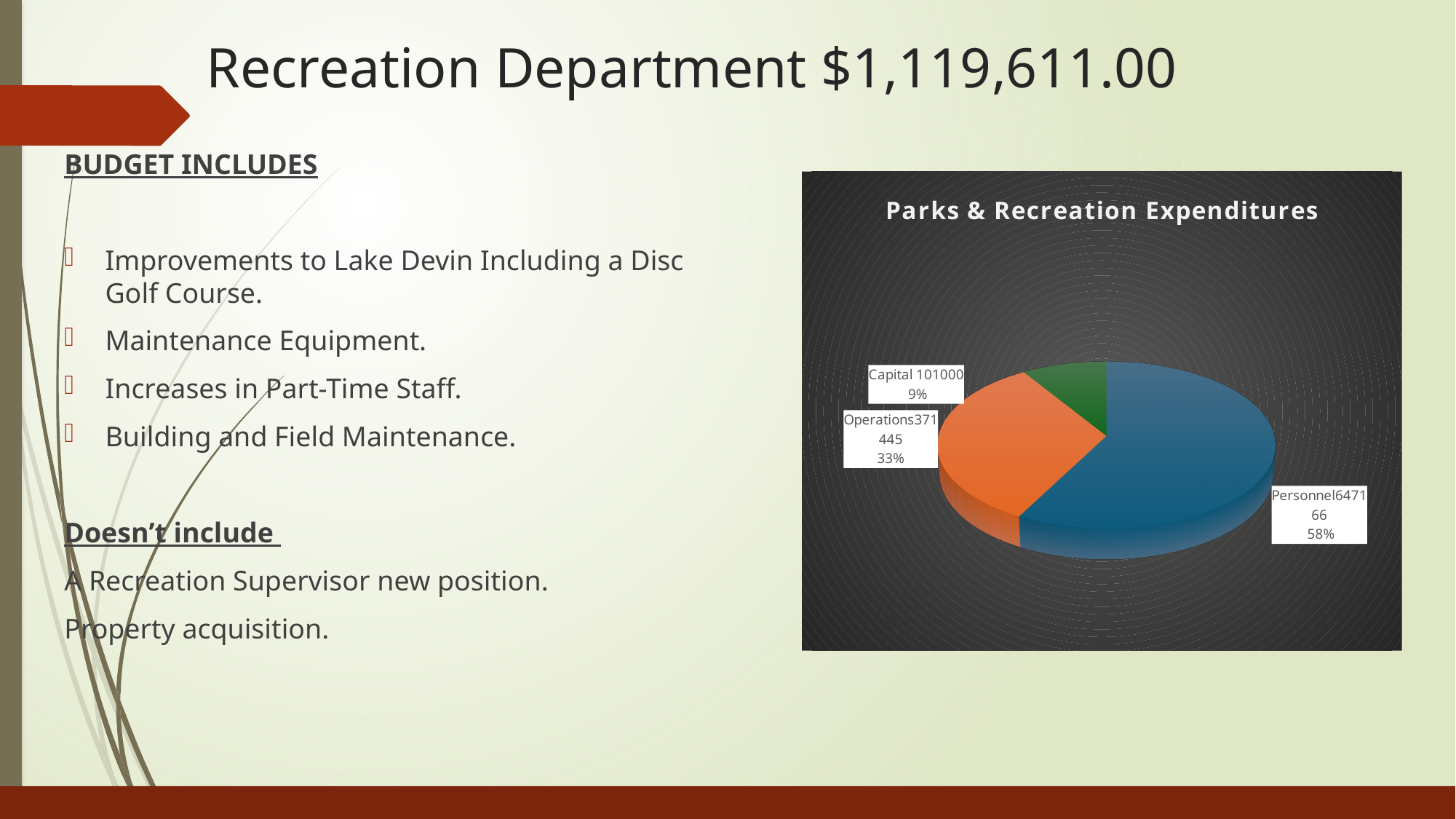
Which is larger, the Operations slice or the Capital slice? Operations How many slices does the pie chart have? 3 Which category has the largest slice of the pie? Personnel What is the value shown for Capital? 101000 What is the value shown for Operations? 371445 What kind of chart is shown on the slide? pie chart What share of the pie does Capital represent? 9% What is the value shown for Personnel? 647166 What is the title of the chart? Parks & Recreation Expenditures What share of the pie does Operations represent? 33% What share of the pie does Personnel represent? 58% Which category has the smallest slice of the pie? Capital